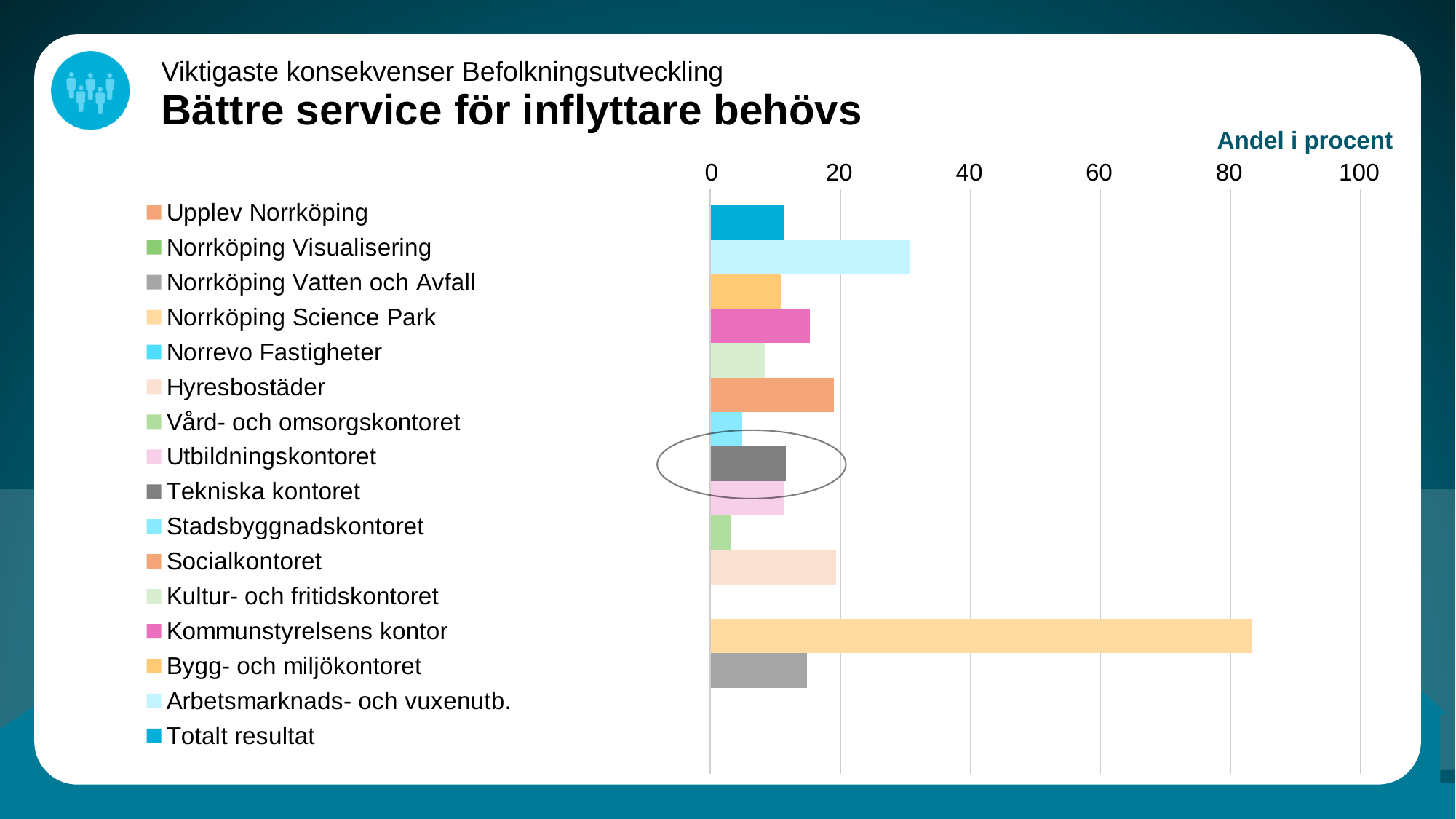
Is the value for Stadsbyggnadskontoret greater or less than 20? less Which series' bar is circled in the chart? Tekniska kontoret Is the value for Totalt resultat greater or less than 20? less Is the value for Arbetsmarknads- och vuxenutb. greater or less than 20? greater Which series has the highest value in the chart? Norrköping Science Park What kind of chart is shown on the slide? bar chart How many series does the legend list? 16 Which is larger, the value for Arbetsmarknads- och vuxenutb. or the value for Socialkontoret? Arbetsmarknads- och vuxenutb. What label is shown above the horizontal axis of the chart? Andel i procent Which is larger, the value for Kommunstyrelsens kontor or the value for Kultur- och fritidskontoret? Kommunstyrelsens kontor